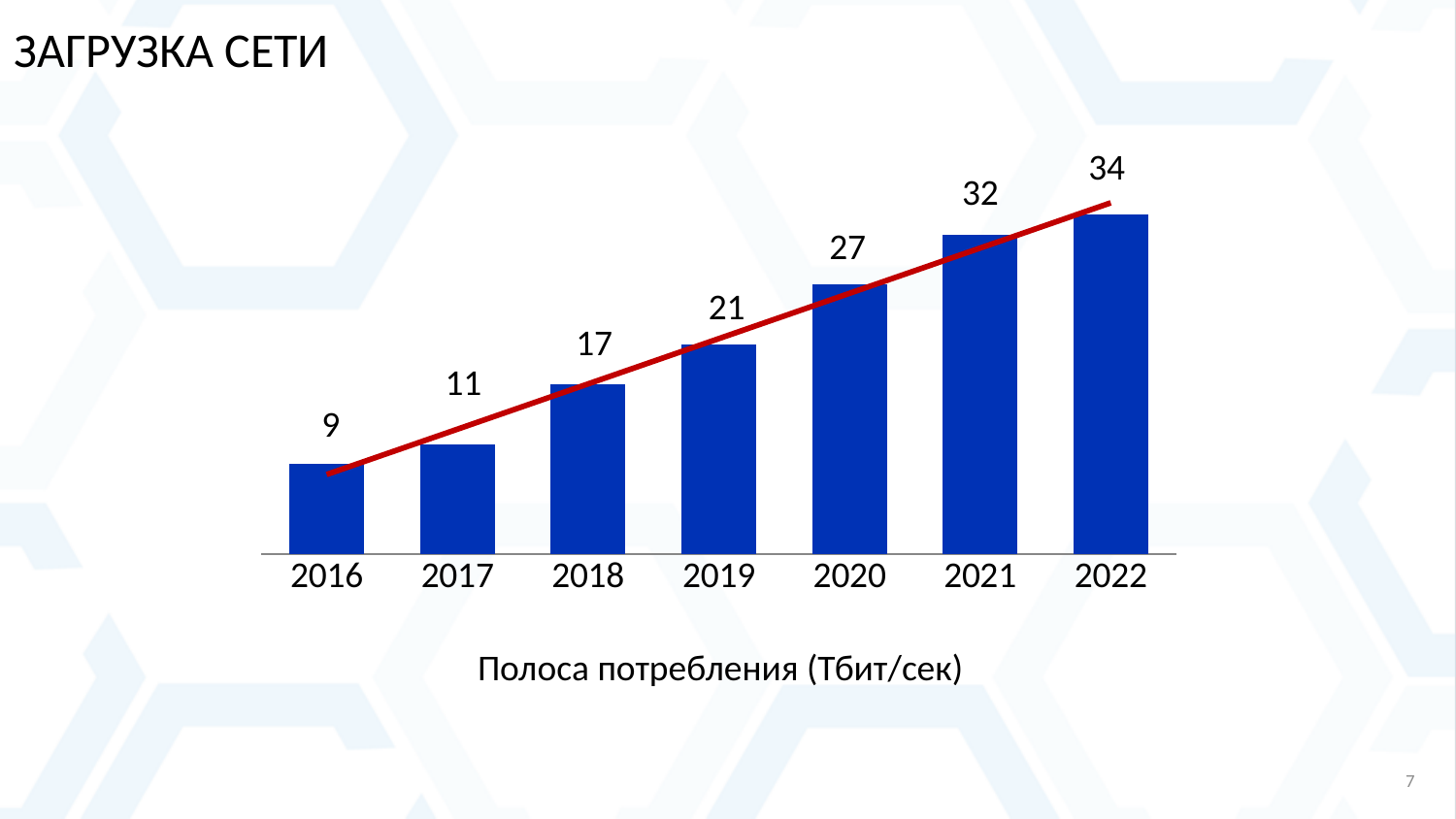
What is the value for 2022? 34 How many years are shown on the x axis? 7 Do the values rise or fall from 2016 to 2022? rise What is the difference between the values for 2020 and 2019? 6 Which is larger, the value for 2017 or the value for 2020? 2020 What is the value for 2019? 21 Which year has the lowest value? 2016 What kind of chart is this? bar chart What is the title of the chart below the x axis? Полоса потребления (Тбит/сек) Which year has the highest value? 2022 What is the difference between the values for 2021 and 2018? 15 What is the value for 2016? 9